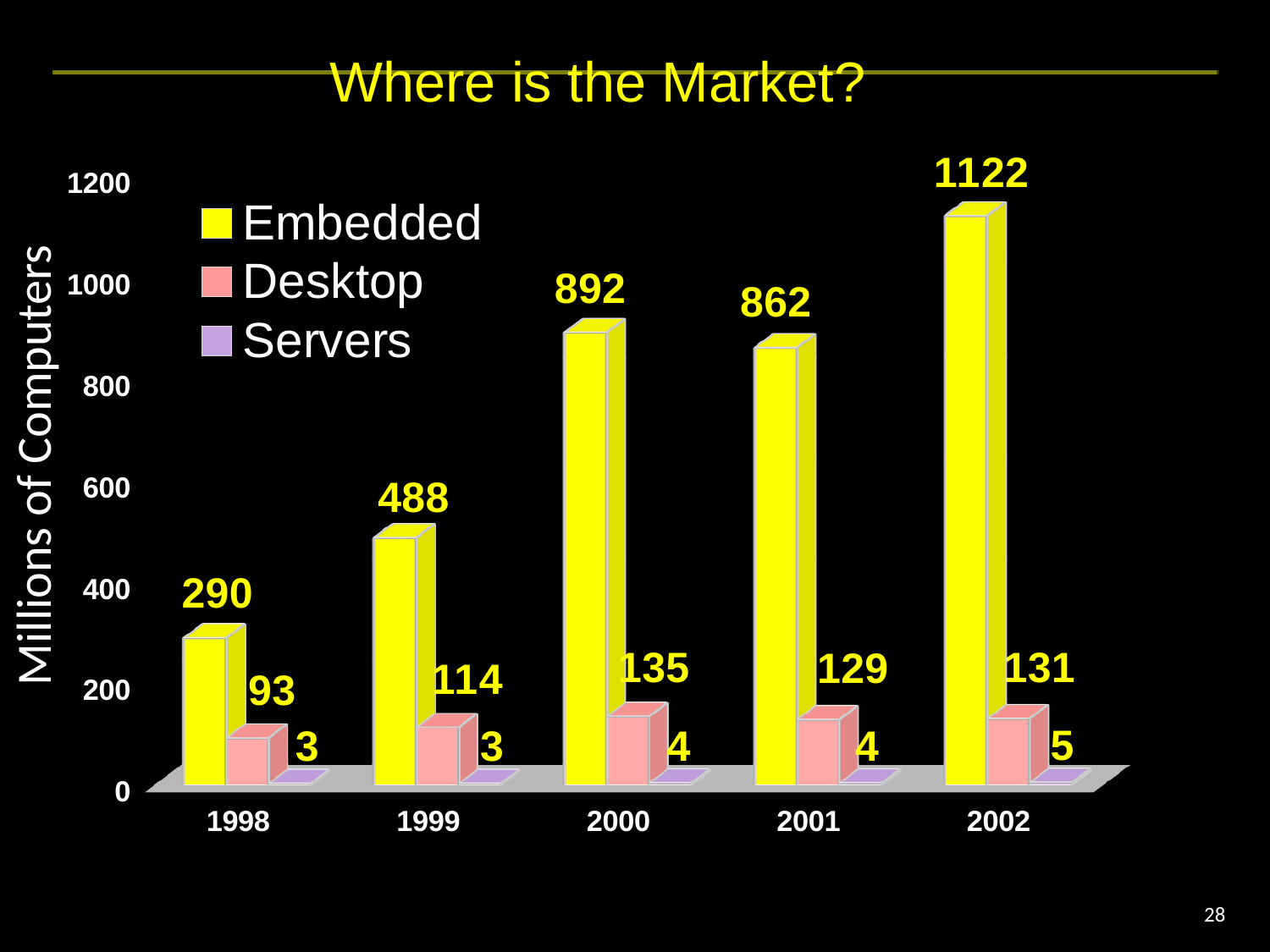
Which year has the lowest Desktop value? 1998 Does the Embedded value rise or fall from 1998 to 1999? rise Which is larger, the Desktop value for 2000 or the Desktop value for 2002? 2000 What is the Desktop value for 1999? 114 What is the Embedded value for 2002? 1122 How many years are shown on the x axis? 5 What is the difference between the Embedded values for 2000 and 2001? 30 How many series does the legend list? 3 What is the Servers value for 2002? 5 What kind of chart is shown on the slide? bar chart Which year has the highest Embedded value? 2002 What is the label on the vertical axis? Millions of Computers